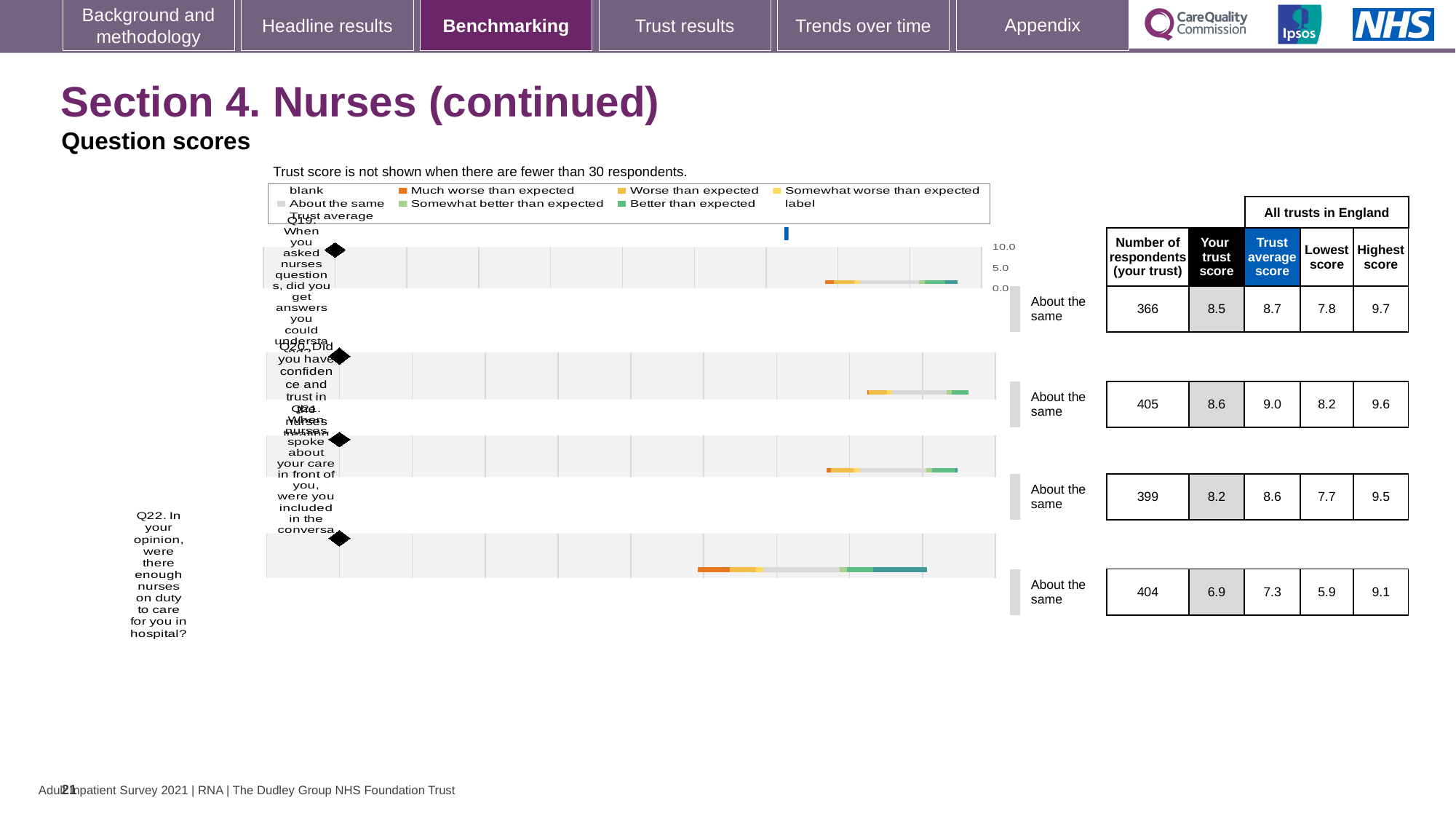
How many respondents from your trust answered Q20? 405 What is the 'Trust average score' for Q20 (confidence and trust in nurses)? 9.0 What is the 'Your trust score' for Q22 (were there enough nurses on duty)? 6.9 For Q19, what is the difference between the trust average score (8.7) and your trust score (8.5)? 0.2 Which colour in the legend represents 'Much worse than expected'? Orange How many questions (categories) are plotted in the chart? 4 For Q21, which is larger: your trust score or the trust average score? Trust average score Which question has the highest 'Your trust score'? Q20 What is the highest score across all trusts in England for Q19? 9.7 Which question has the lowest 'Your trust score'? Q22 What kind of chart is used to show the question scores on this slide? Bar chart